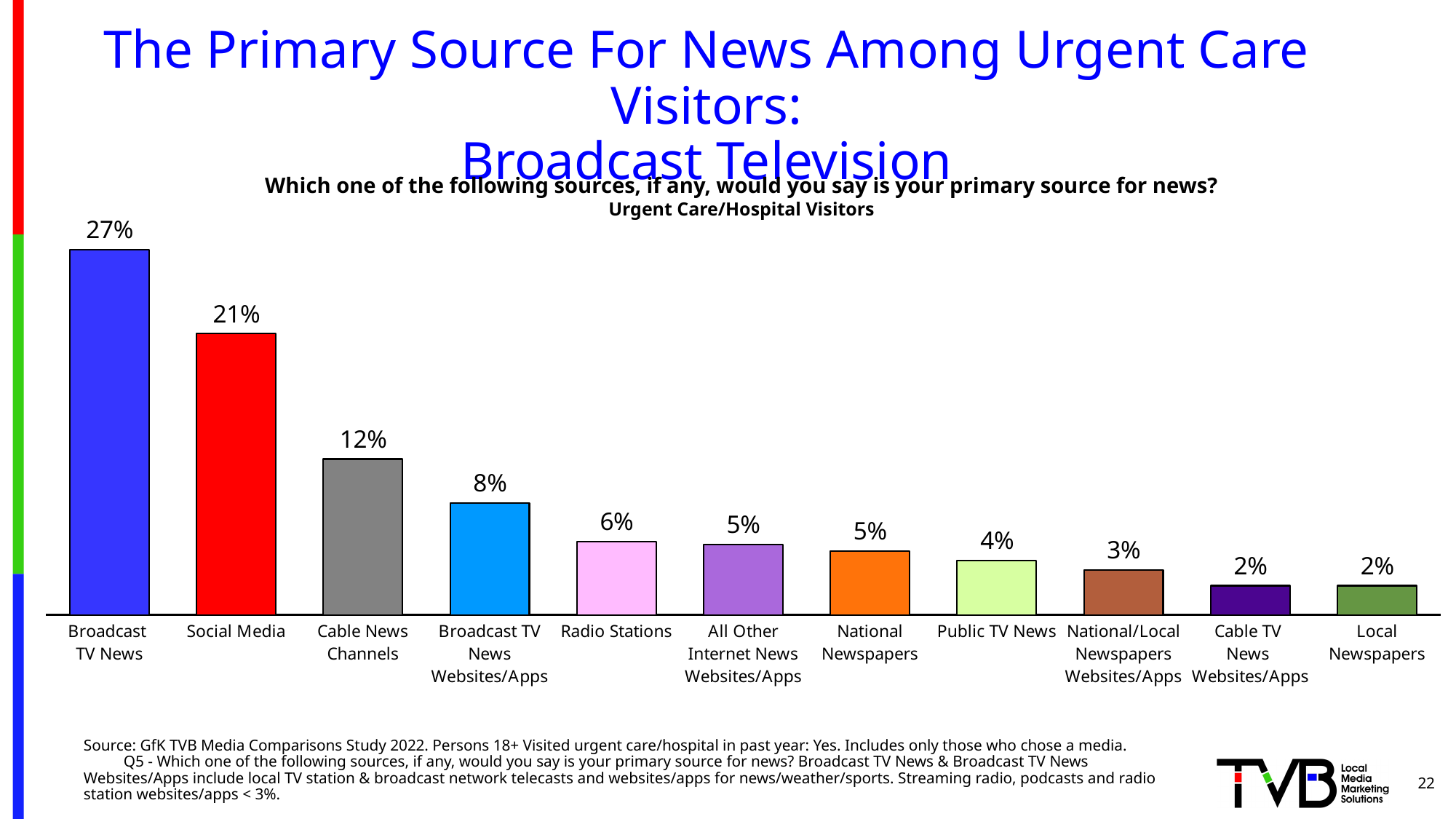
Which is larger, the value for Public TV News or the value for National/Local Newspapers Websites/Apps? Public TV News What kind of chart is shown on the slide? Bar chart What is the value shown for Cable News Channels? 12% What is the difference between the values for Broadcast TV News and Social Media? 6% What is the value shown for Social Media? 21% Which news source has the highest value on the chart? Broadcast TV News How many news source categories are shown on the chart? 11 What is the difference between the values for Cable News Channels and Broadcast TV News Websites/Apps? 4% What percentage of urgent care/hospital visitors say Broadcast TV News is their primary source for news? 27% Do the values rise or fall moving from left to right across the chart? Fall What colour is the bar for Social Media? Red What is the value shown for Radio Stations? 6%